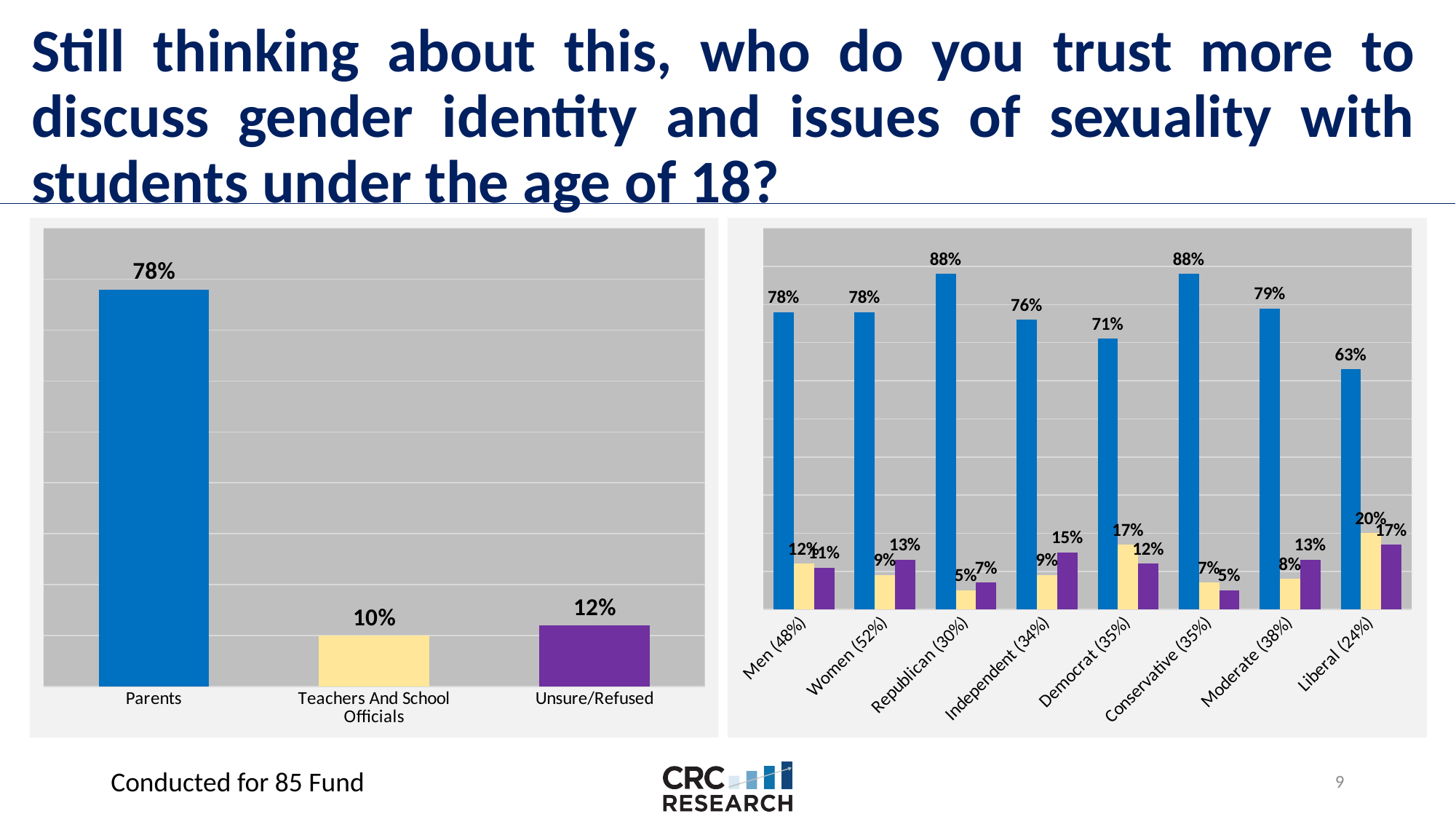
In the right chart, what is the difference between the blue bars for Conservative (35%) and Liberal (24%)? 25% How many groups are shown on the x axis of the right chart? 8 In the left chart, what is the value for Parents? 78% In the right chart, which group has the lowest blue bar? Liberal (24%) In the right chart, what is the value of the purple bar for Independent (34%)? 15% How many categories are shown in the left chart? 3 In the right chart, what is the value of the yellow bar for Liberal (24%)? 20% What kind of chart is the left chart? Bar chart In the right chart, is the blue bar for Democrat (35%) larger or smaller than the blue bar for Moderate (38%)? Smaller In the left chart, which category has the lowest value? Teachers And School Officials In the left chart, what is the difference between the values for Parents and Unsure/Refused? 66% In the right chart, what is the value of the blue bar for Republican (30%)? 88%